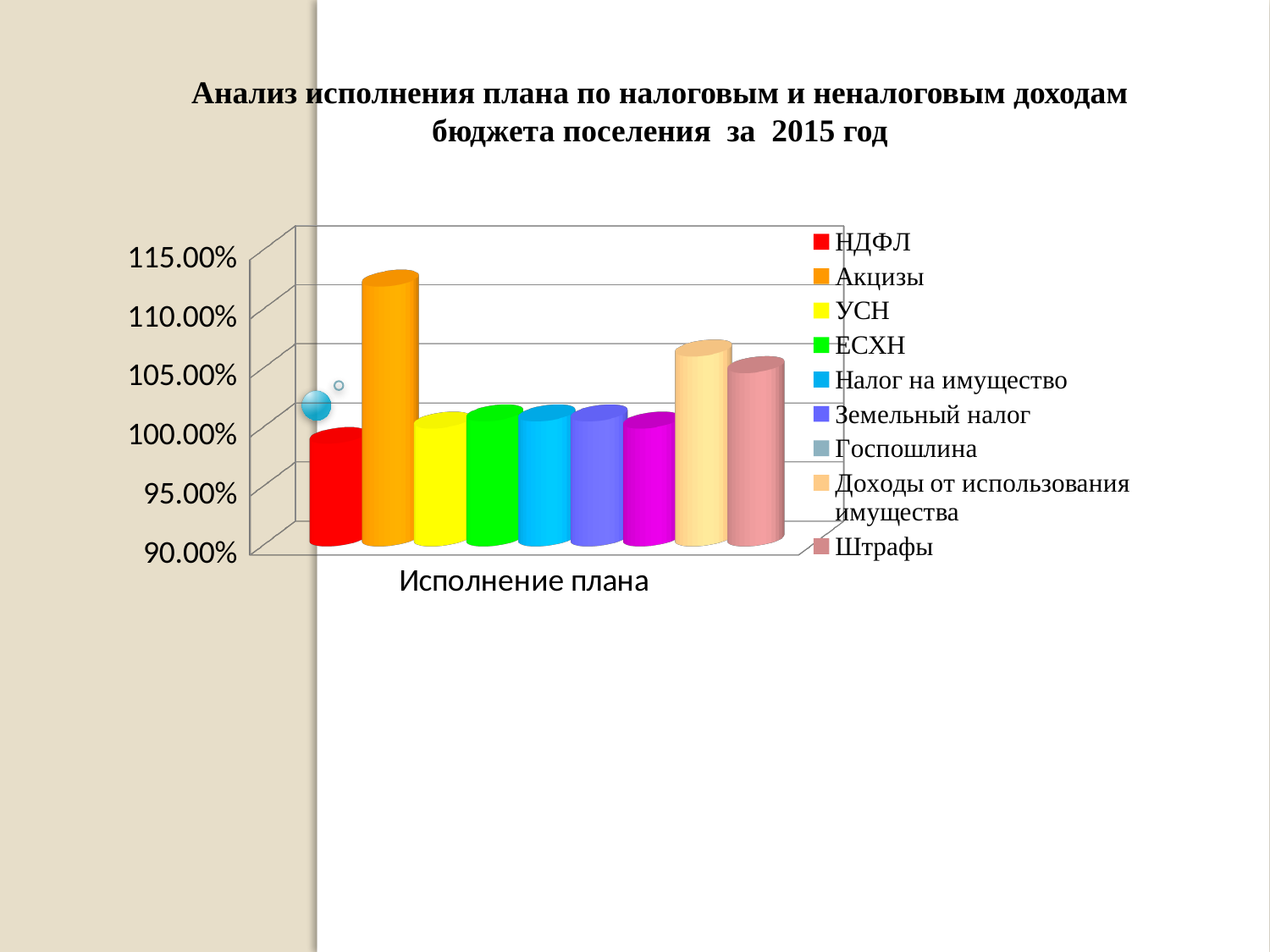
Is the value for Акцизы greater or less than 115.00%? less How many categories are shown on the x axis? 1 Which series is listed first in the legend? НДФЛ Is the value for Штрафы greater or less than 100.00%? greater Which is larger, the value for Доходы от использования имущества or the value for НДФЛ? Доходы от использования имущества Which is larger, the value for Акцизы or the value for Штрафы? Акцизы Is the value for Акцизы greater or less than 110.00%? greater Which series has the highest value? Акцизы What kind of chart is shown on the slide? bar chart What is the category label shown on the x axis? Исполнение плана How many series does the legend list? 9